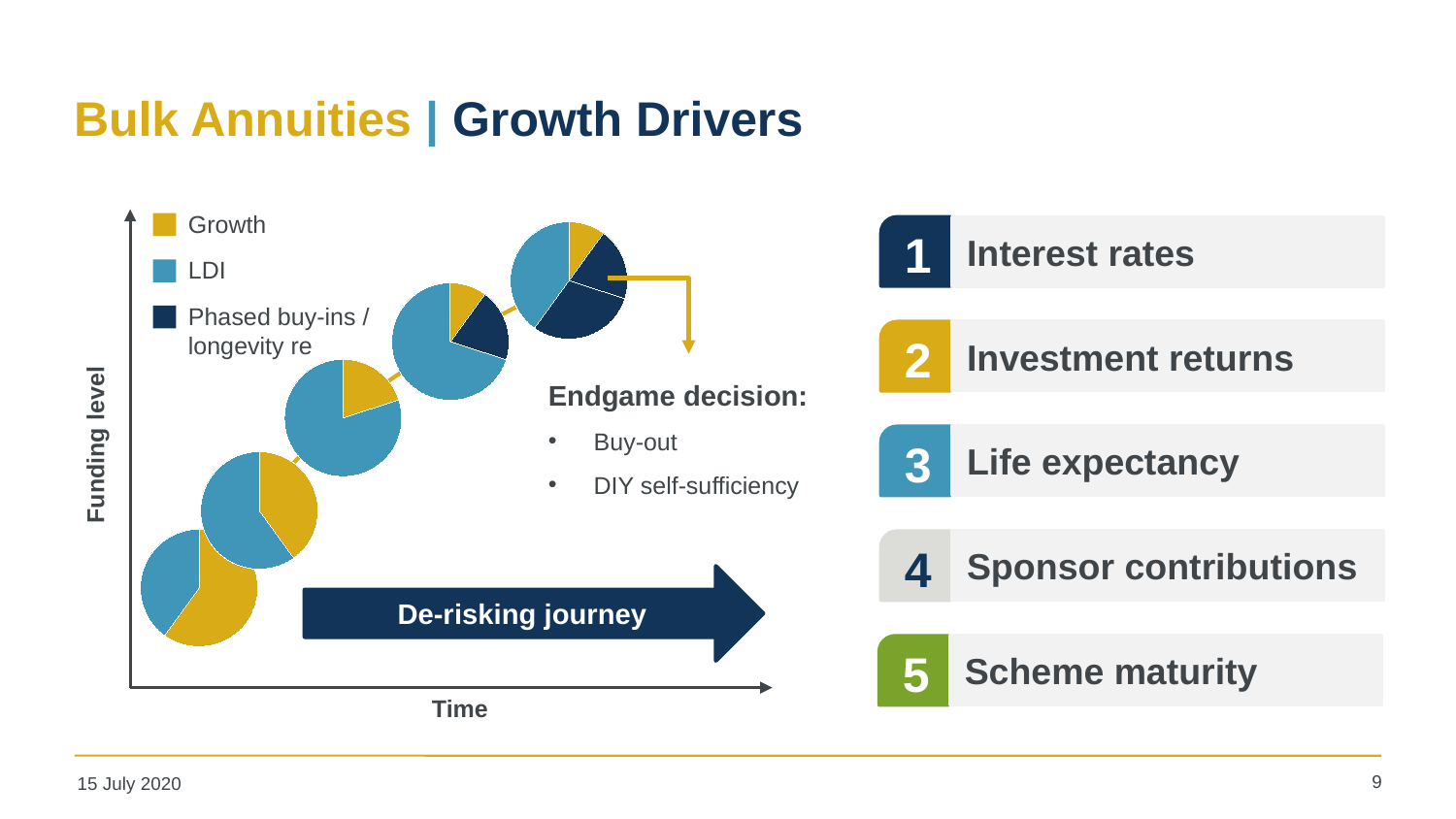
In the first (lowest) pie chart, which is the larger slice: Growth or LDI? Growth What is the label on the horizontal axis? Time How many entries does the legend list? 3 Does the Growth slice get larger or smaller as the pie charts move along the Time axis? Smaller In the last (highest) pie chart, which is the larger slice: Growth or LDI? LDI In the last (highest) pie chart, which slice is the smallest? Growth What kind of charts are plotted along the Funding level / Time axes? Pie charts Which legend entry is represented by the dark navy colour? Phased buy-ins / longevity re What is the label on the vertical axis? Funding level Does the funding level rise or fall as the pie charts move along the Time axis? Rise How many pie charts are shown along the de-risking journey? 5